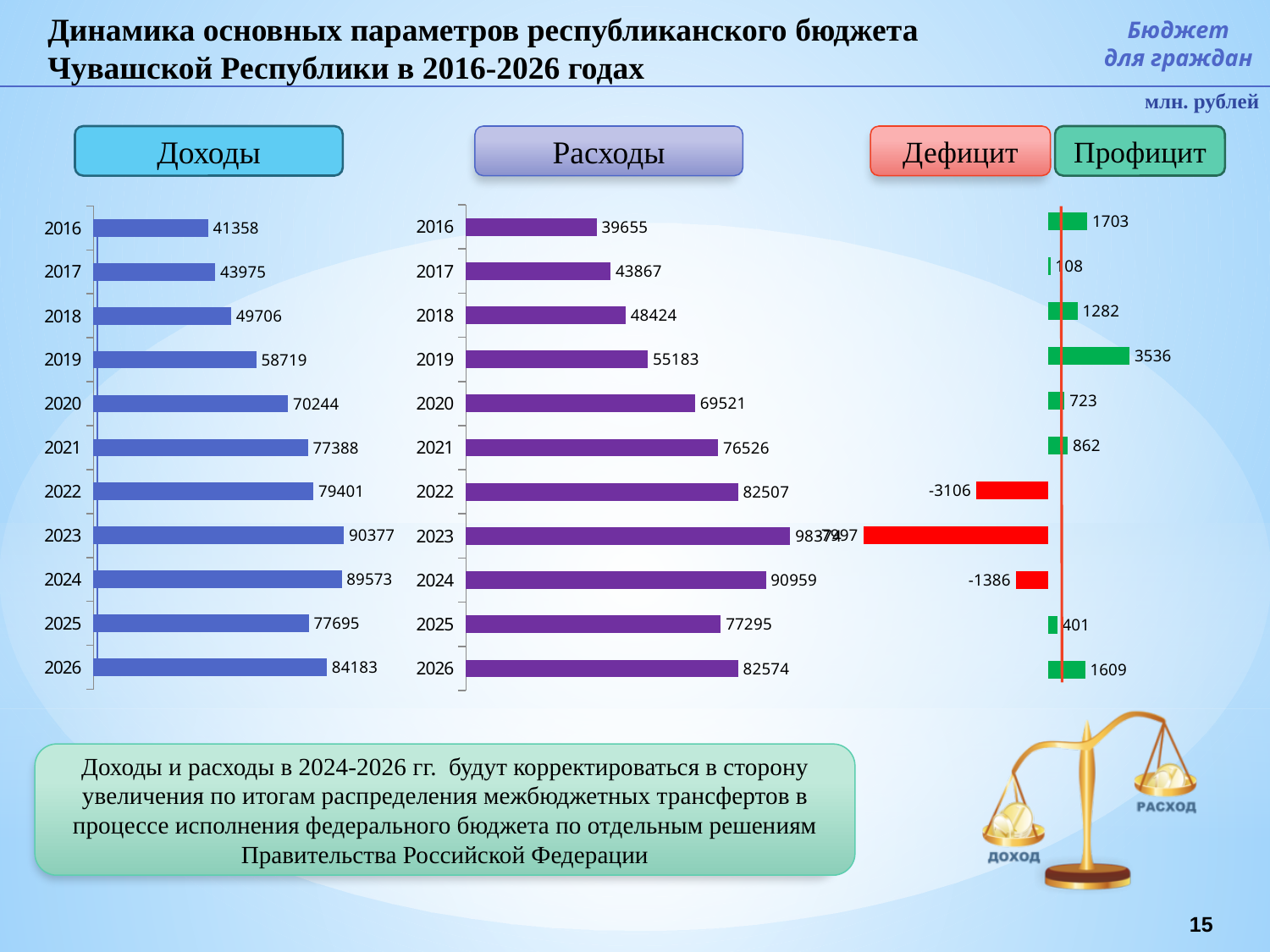
On the Доходы chart, do the values rise or fall from 2016 to 2023? Rise On the Доходы chart, which year has the highest value? 2023 On the Дефицит/Профицит chart, what is the value for 2022? -3106 On the Расходы chart, which year has the lowest value? 2016 On the Дефицит/Профицит chart, which year has the largest surplus (профицит)? 2019 On the Расходы chart, what is the difference between the values for 2020 and 2019? 14338 On the Доходы chart, what is the difference between the values for 2026 and 2025? 6488 On the Доходы chart, what is the value for 2019? 58719 For 2022, which is larger: the value on the Доходы chart or the value on the Расходы chart? Расходы How many years are shown on the Доходы chart? 11 What kind of chart is the Расходы chart? Bar chart On the Расходы chart, what is the value for 2024? 90959